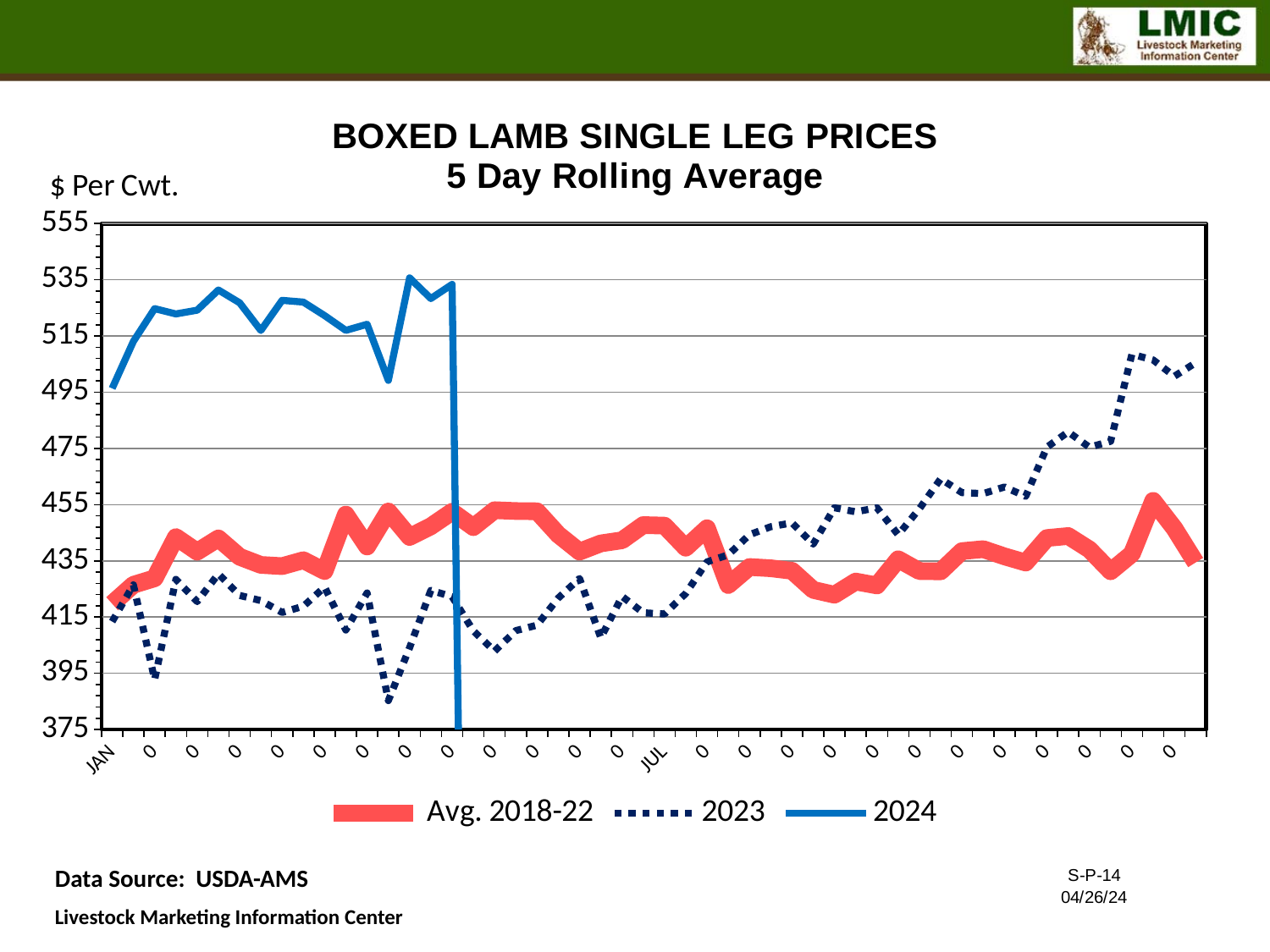
Is the value for Avg. 2018-22 at JAN greater or less than 435? less Which series reaches the lowest value on the chart? 2023 What kind of chart is shown on the slide? line chart What unit is shown on the y axis of the chart? $ Per Cwt. Is the value for 2024 at JAN greater or less than 475? greater Does the 2023 series rise or fall from JUL to the end of the year? rise How many series does the legend list? 3 What is the title of the chart? BOXED LAMB SINGLE LEG PRICES 5 Day Rolling Average Is the last plotted value for 2023 greater or less than 475? greater At JAN, which series is higher, 2024 or 2023? 2024 Which series reaches the highest value on the chart? 2024